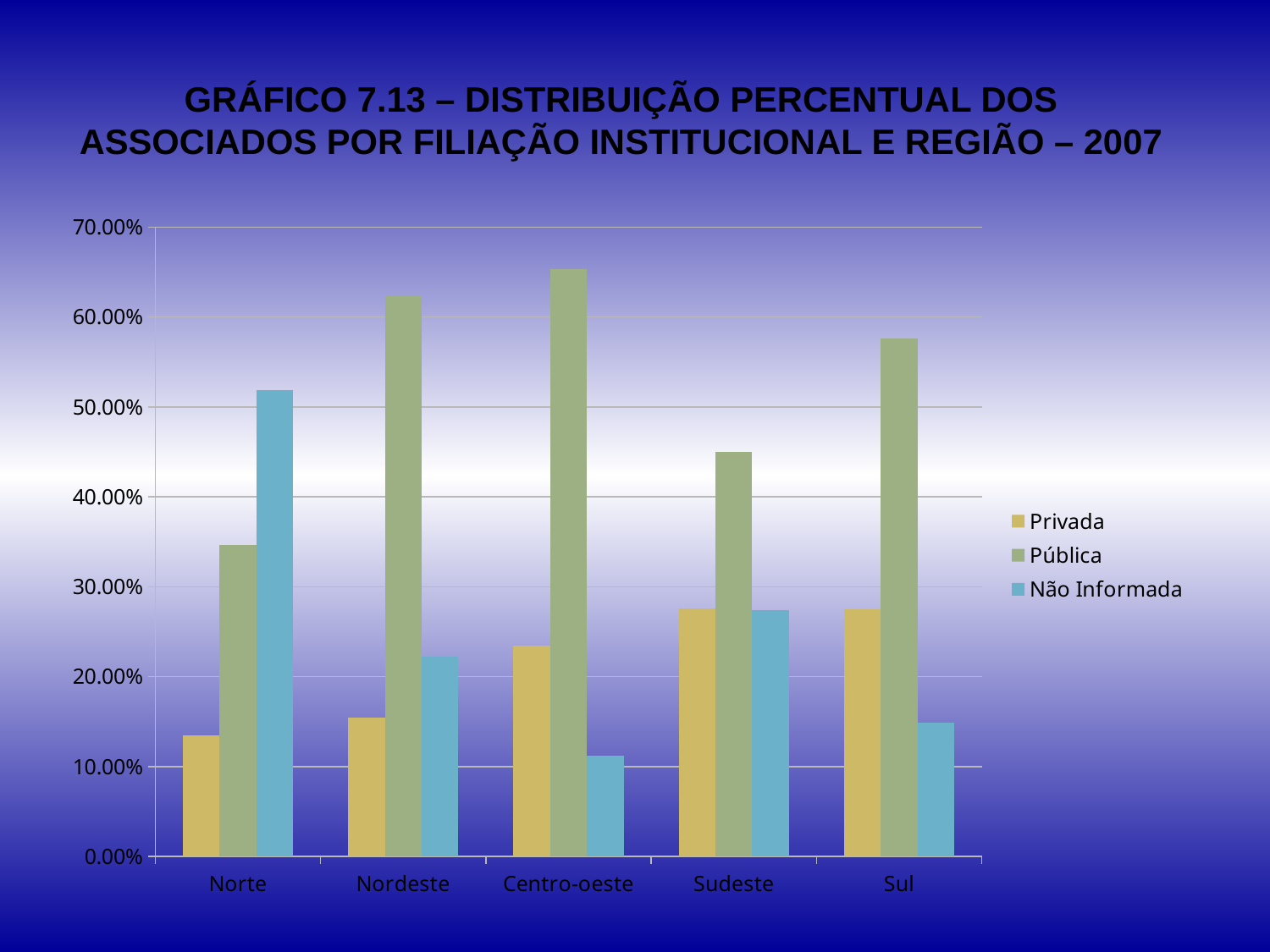
What kind of chart is shown on the slide? bar chart Which region has the lowest value for Pública? Norte Which region has the highest value for Não Informada? Norte How many regions are shown on the x axis? 5 Which region has the highest value for Pública? Centro-oeste Is the value for Pública in Nordeste greater or less than 60.00%? greater Which region has the lowest value for Não Informada? Centro-oeste Is the value for Não Informada in Norte greater or less than 50.00%? greater In Norte, which is larger: the value for Pública or the value for Não Informada? Não Informada Is the value for Pública in Sul greater or less than 60.00%? less Which series is shown in blue in the legend? Não Informada How many series does the legend list? 3